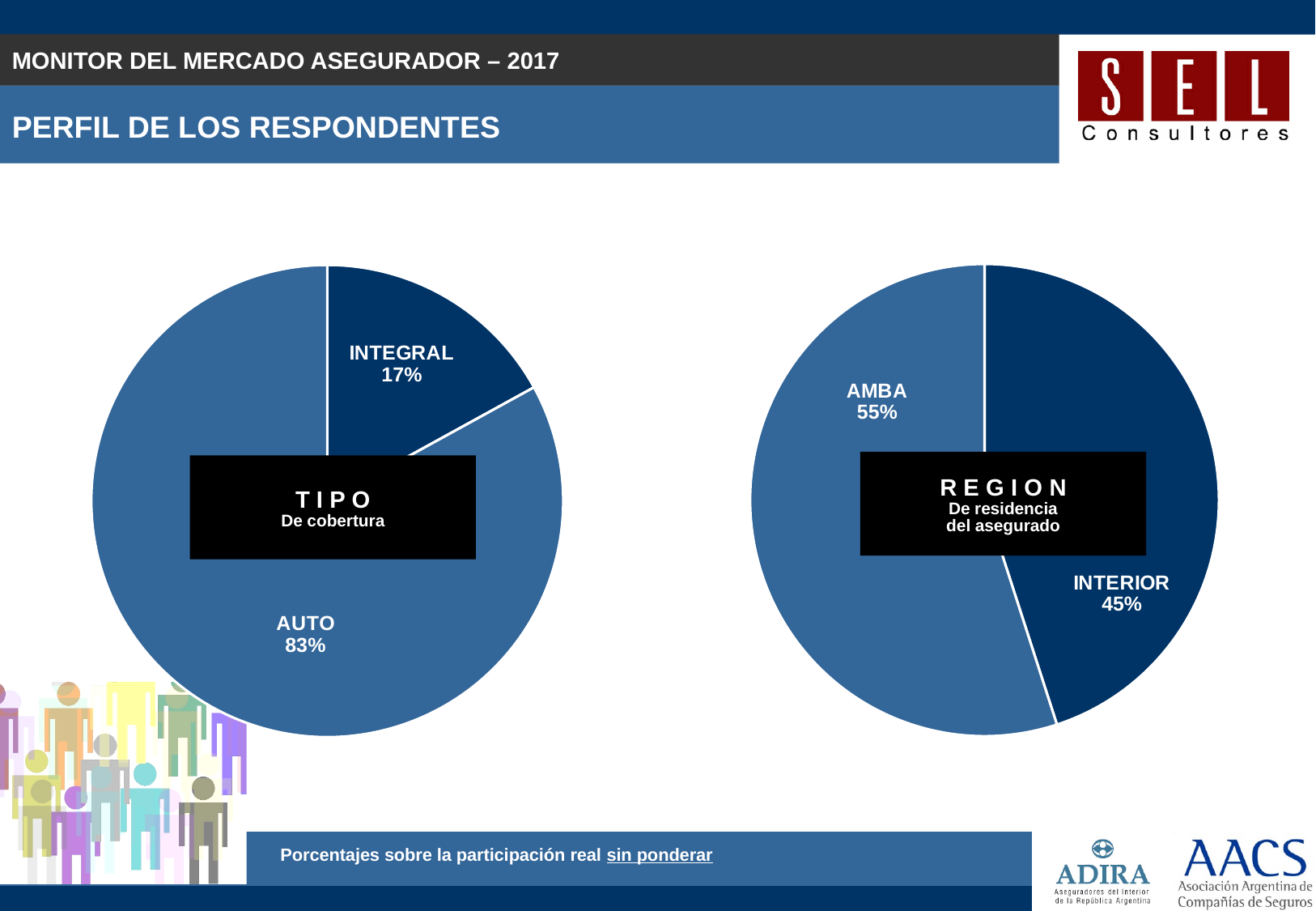
In the REGION chart on the right, which is larger, AMBA or INTERIOR? AMBA In the REGION chart on the right, which category has the smallest share? INTERIOR What type of chart is the REGION chart on the right? Pie chart In the TIPO de cobertura chart on the left, what percentage is INTEGRAL? 17% In the TIPO de cobertura chart on the left, which category has the largest share? AUTO How many slices does the TIPO de cobertura chart on the left have? 2 In the TIPO de cobertura chart on the left, what percentage is AUTO? 83% What is the title shown in the centre of the chart on the right? REGION De residencia del asegurado In the TIPO de cobertura chart on the left, what is the difference in percentage points between AUTO and INTEGRAL? 66 In the REGION chart on the right, what is the difference in percentage points between AMBA and INTERIOR? 10 In the REGION chart on the right, what percentage is AMBA? 55% In the REGION chart on the right, what percentage is INTERIOR? 45%